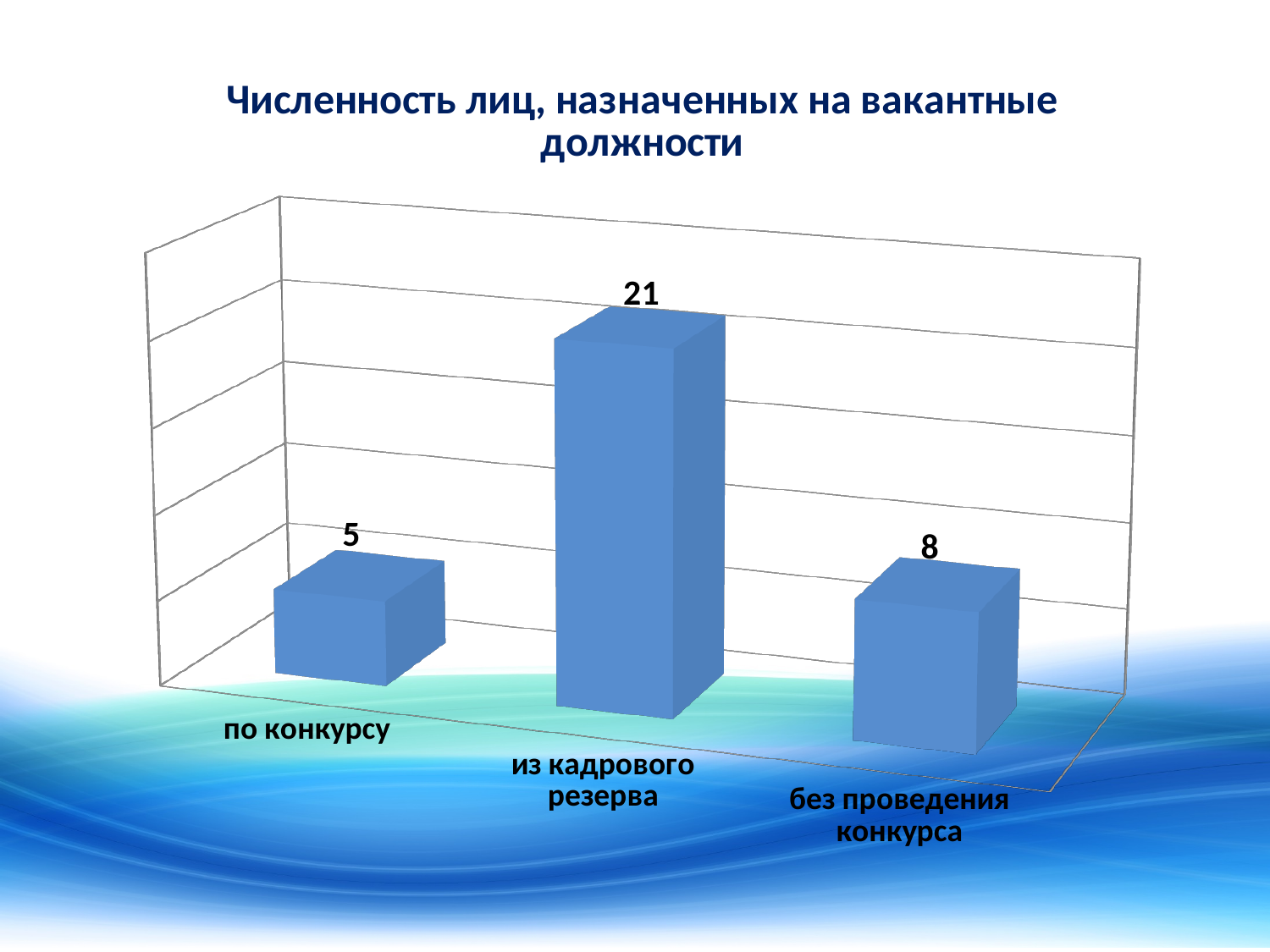
What is the value for "по конкурсу"? 5 What is the difference between the values for "из кадрового резерва" and "без проведения конкурса"? 13 Which category has the highest value? из кадрового резерва What is the value for "из кадрового резерва"? 21 Which is larger: the value for "по конкурсу" or the value for "без проведения конкурса"? без проведения конкурса Which category has the lowest value? по конкурсу What is the value for "без проведения конкурса"? 8 What is the title of the chart? Численность лиц, назначенных на вакантные должности What kind of chart is shown on the slide? bar chart What is the total of the three values shown in the chart? 34 What is the difference between the values for "без проведения конкурса" and "по конкурсу"? 3 How many categories are shown in the chart? 3